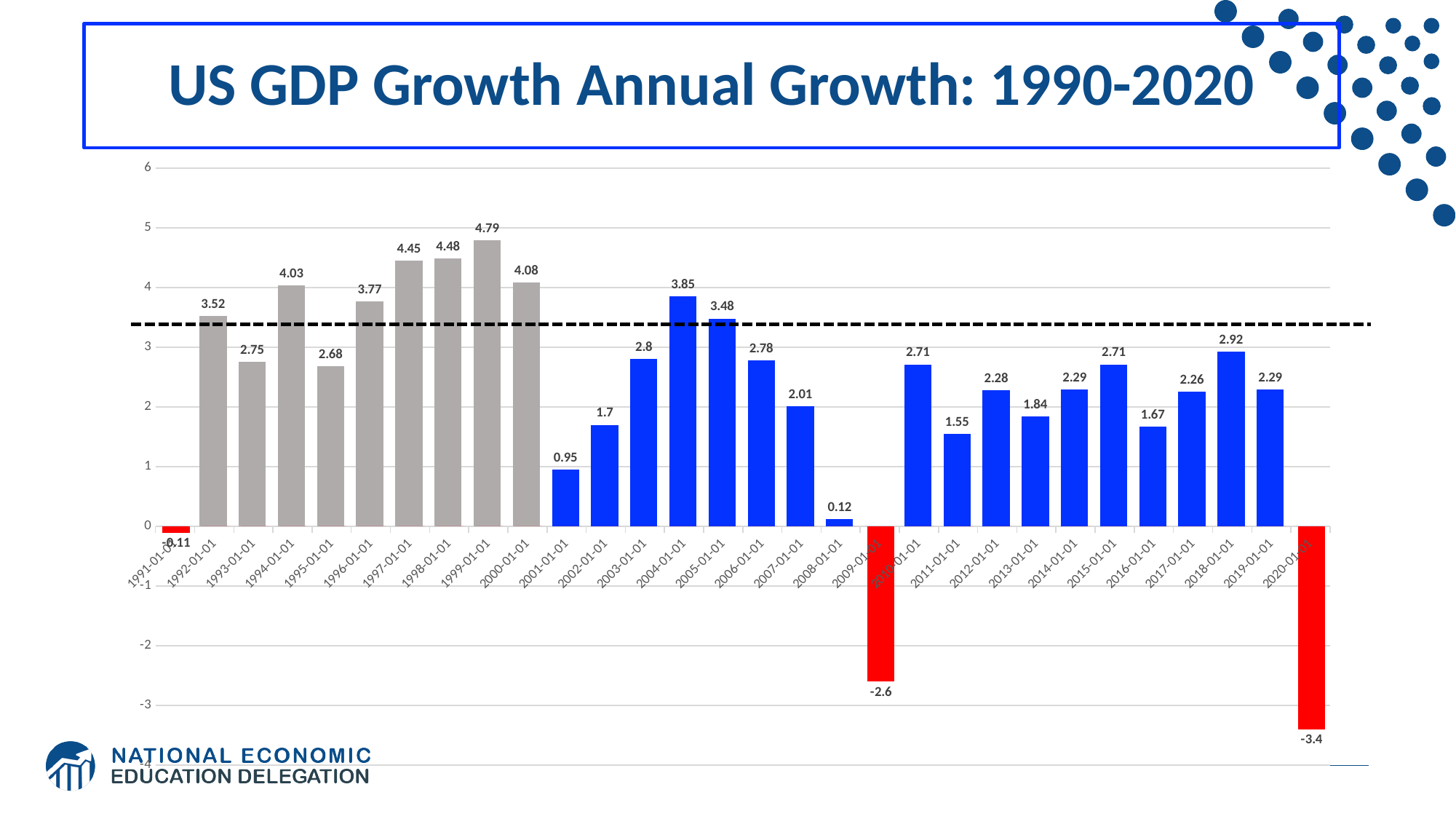
What is the value for 2020-01-01? -3.4 What is the value for 2009-01-01? -2.6 How many bars are plotted in the chart? 30 What is the value for 2008-01-01? 0.12 What kind of chart is shown on the slide? bar chart Which year has the lowest value? 2020-01-01 Which is larger, the value for 2018-01-01 or the value for 2019-01-01? 2018-01-01 Is the value for 1996-01-01 greater or less than 3? greater What colour are the bars for the years with negative values? red What is the value for 1999-01-01? 4.79 What is the difference between the values for 2004-01-01 and 2005-01-01? 0.37 Which year has the highest value? 1999-01-01